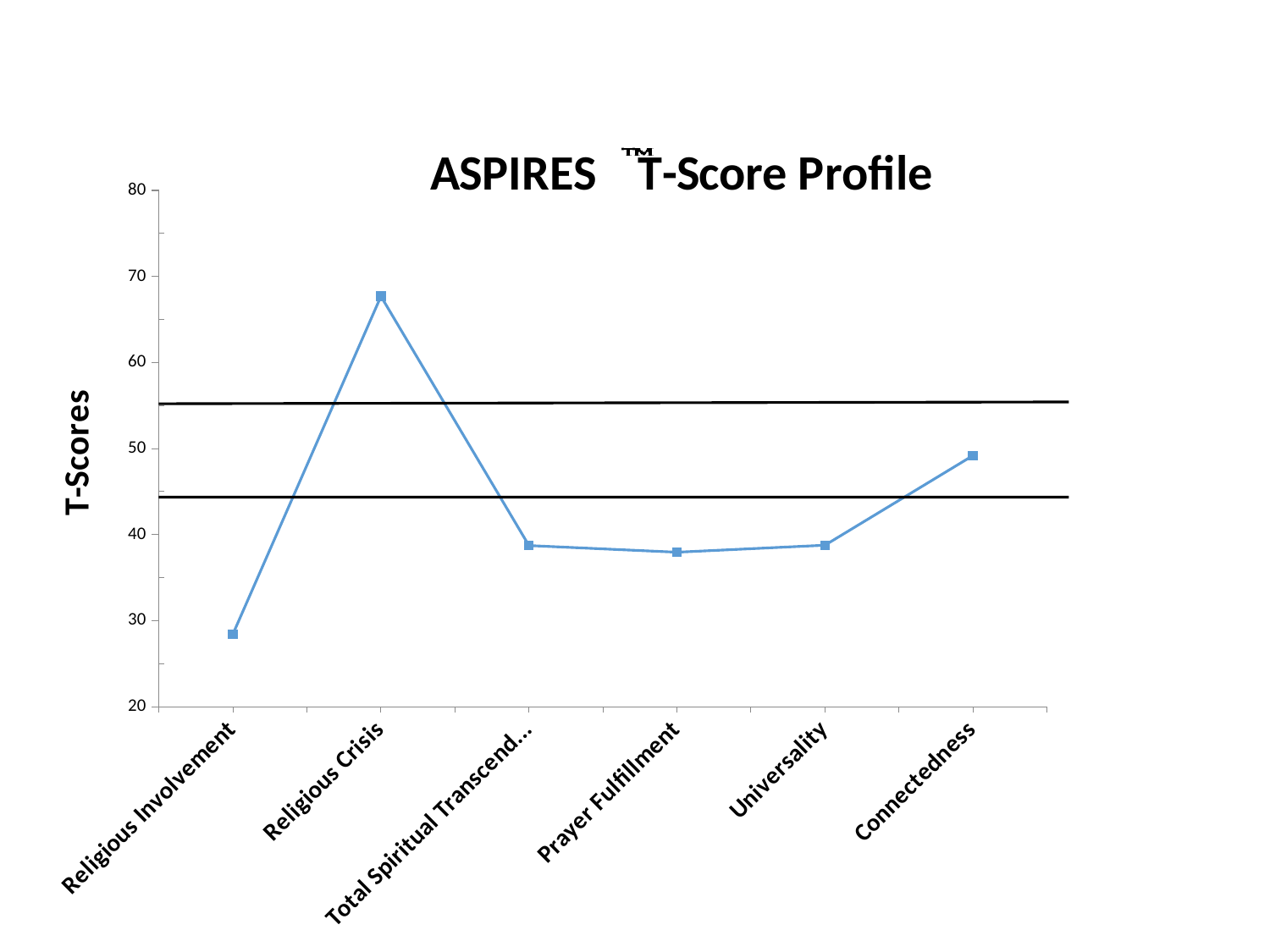
How many categories are plotted along the x axis? 6 What kind of chart is shown on the slide? line chart Is the value for Connectedness greater or less than 40? greater What is the label on the y axis? T-Scores Is the value for Religious Crisis greater or less than 60? greater Which category has the highest T-score? Religious Crisis Which is larger, the value for Religious Crisis or the value for Connectedness? Religious Crisis Is the value for Religious Involvement greater or less than 30? less Does the line rise or fall from Religious Involvement to Religious Crisis? rise Which is larger, the value for Connectedness or the value for Universality? Connectedness Which category has the lowest T-score? Religious Involvement